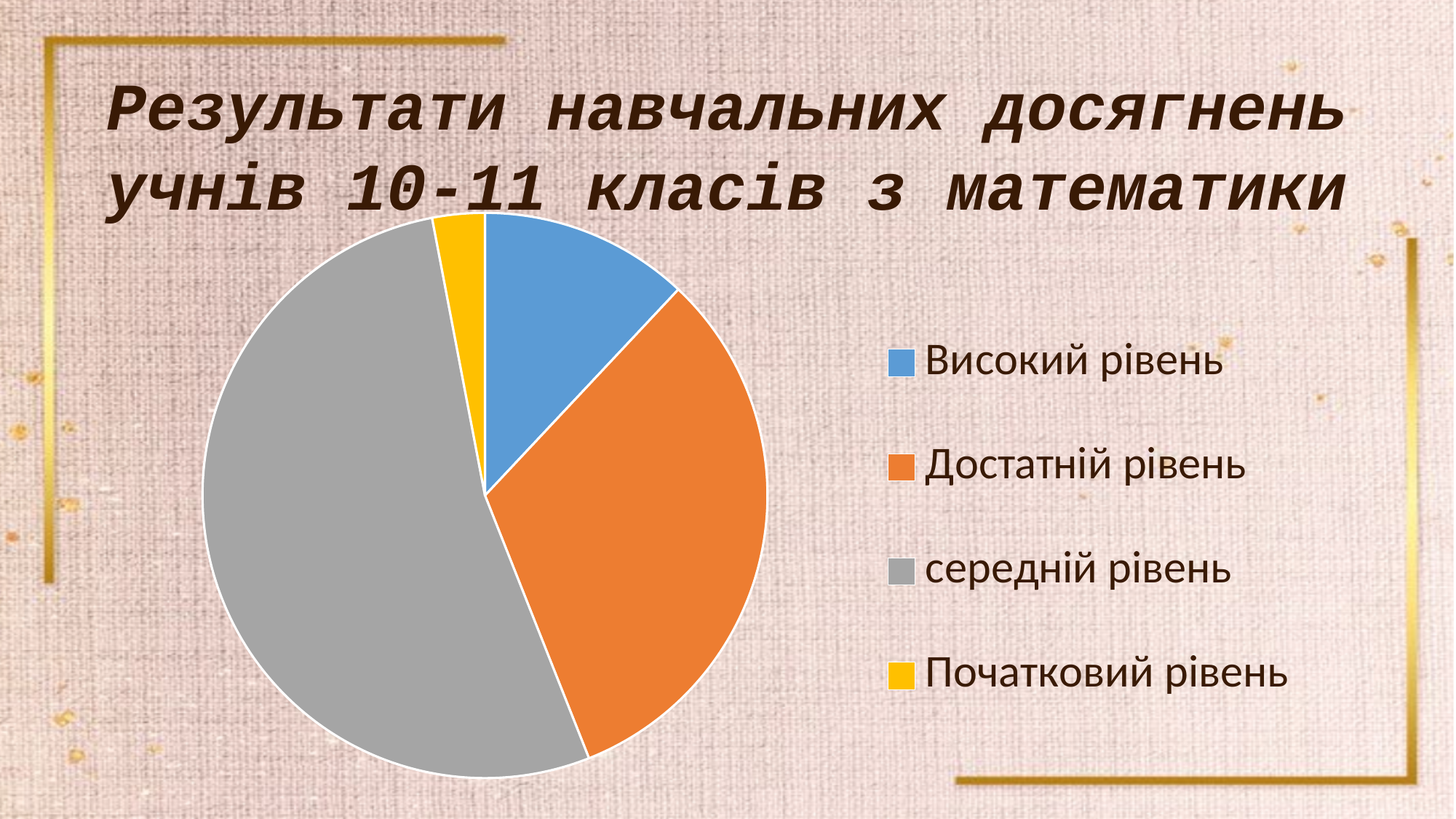
How many slices does the pie chart have? 4 What kind of chart is shown on the slide? Pie chart Which slice is larger: середній рівень or Достатній рівень? середній рівень What is the title of the slide containing the pie chart? Результати навчальних досягнень учнів 10-11 класів з математики What colour is the slice for Достатній рівень in the pie chart? Orange Which category has the largest slice of the pie chart? середній рівень Which category has the smallest slice of the pie chart? Початковий рівень Which slice is larger: Високий рівень or Початковий рівень? Високий рівень Which slice is larger: Достатній рівень or Високий рівень? Достатній рівень How many entries does the legend of the pie chart list? 4